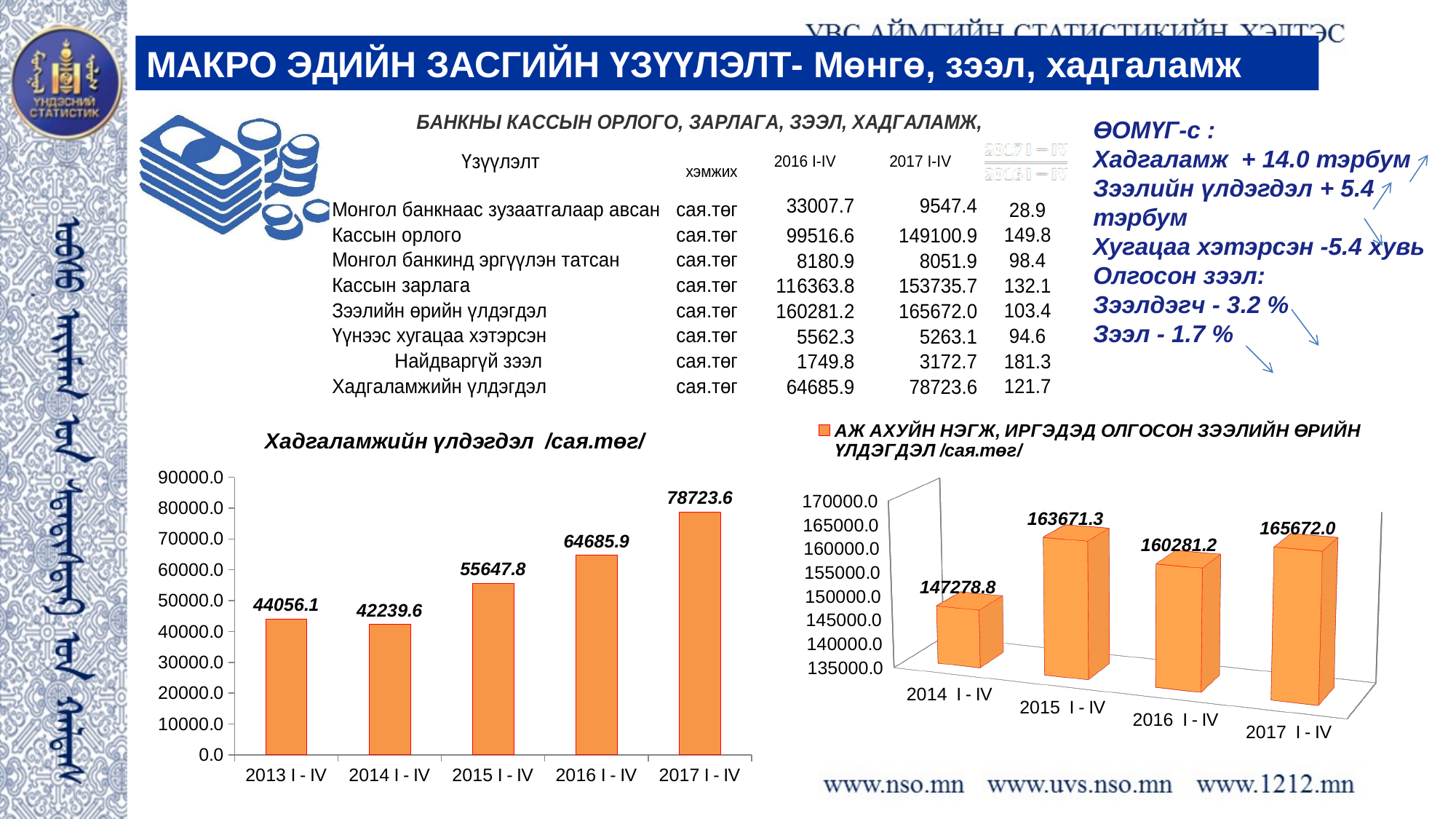
In the right chart (Аж ахуйн нэгж, иргэдэд олгосон зээлийн өрийн үлдэгдэл), which period has the lowest value? 2014 I - IV In the left chart (Хадгаламжийн үлдэгдэл), what kind of chart is it? Bar chart In the left chart (Хадгаламжийн үлдэгдэл), how many periods are shown on the x axis? 5 In the left chart (Хадгаламжийн үлдэгдэл), what is the difference between the 2017 I - IV and 2016 I - IV values? 14037.7 In the right chart (Аж ахуйн нэгж, иргэдэд олгосон зээлийн өрийн үлдэгдэл), which is larger: the value for 2015 I - IV or 2016 I - IV? 2015 I - IV In the right chart (Аж ахуйн нэгж, иргэдэд олгосон зээлийн өрийн үлдэгдэл), what is the difference between the 2017 I - IV and 2014 I - IV values? 18393.2 In the right chart (Аж ахуйн нэгж, иргэдэд олгосон зээлийн өрийн үлдэгдэл), what is the value for 2015 I - IV? 163671.3 In the left chart (Хадгаламжийн үлдэгдэл), what is the value for 2017 I - IV? 78723.6 In the left chart (Хадгаламжийн үлдэгдэл), which period has the highest value? 2017 I - IV In the left chart (Хадгаламжийн үлдэгдэл), what is the value for 2014 I - IV? 42239.6 In the left chart (Хадгаламжийн үлдэгдэл), which period has the lowest value? 2014 I - IV In the right chart (Аж ахуйн нэгж, иргэдэд олгосон зээлийн өрийн үлдэгдэл), how many periods are shown? 4